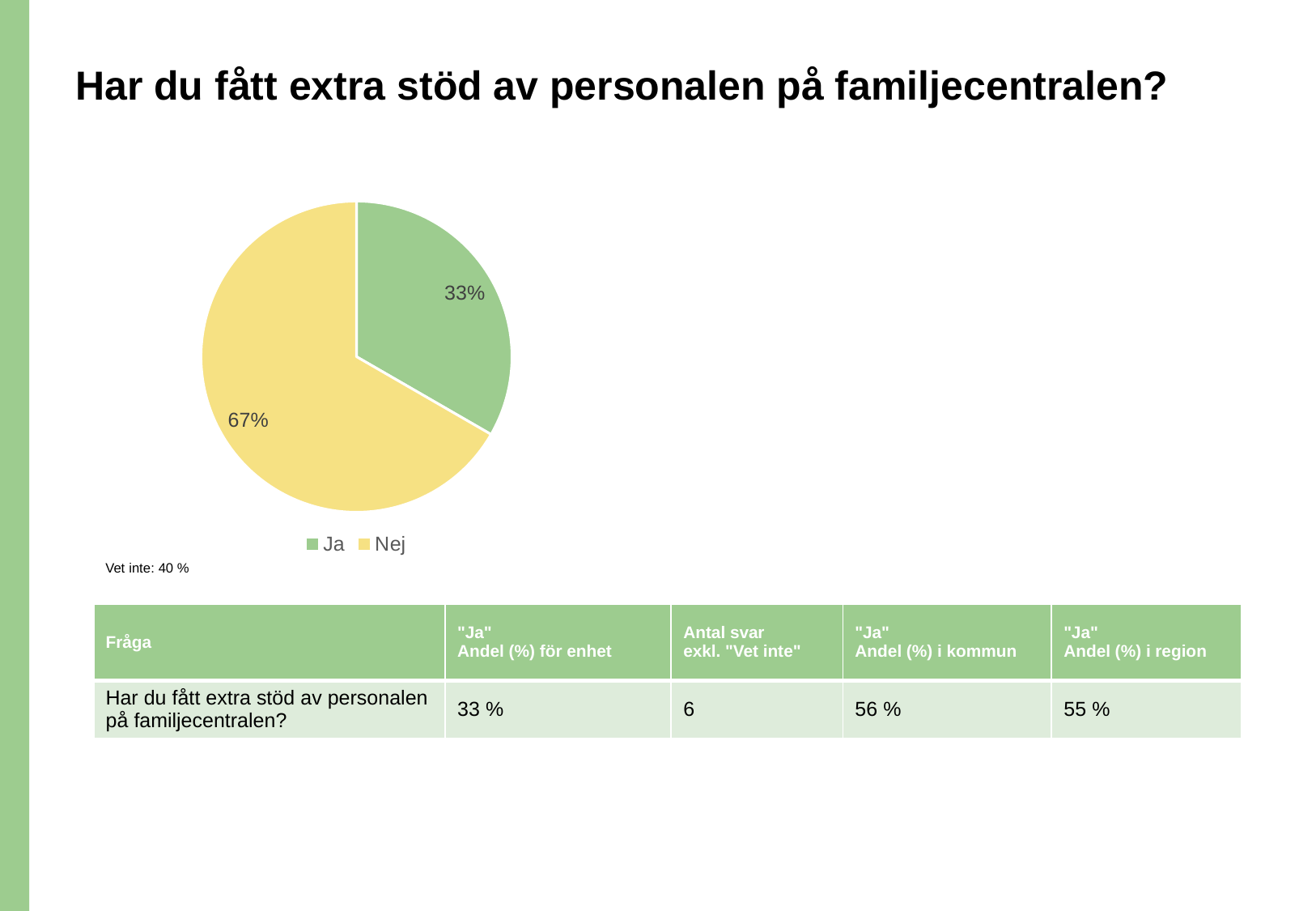
What colour is the "Nej" slice in the pie chart? yellow What share of the pie does "Nej" represent? 67% Which slice of the pie is the largest? Nej How many slices does the pie chart have? 2 Which is larger, the "Ja" slice or the "Nej" slice? Nej What share of the pie does "Ja" represent? 33% What is the difference in percentage points between the "Nej" slice and the "Ja" slice? 34 How many entries does the legend list? 2 Which slice of the pie is the smallest? Ja What kind of chart is shown on the slide? pie chart What colour is the "Ja" slice in the pie chart? green